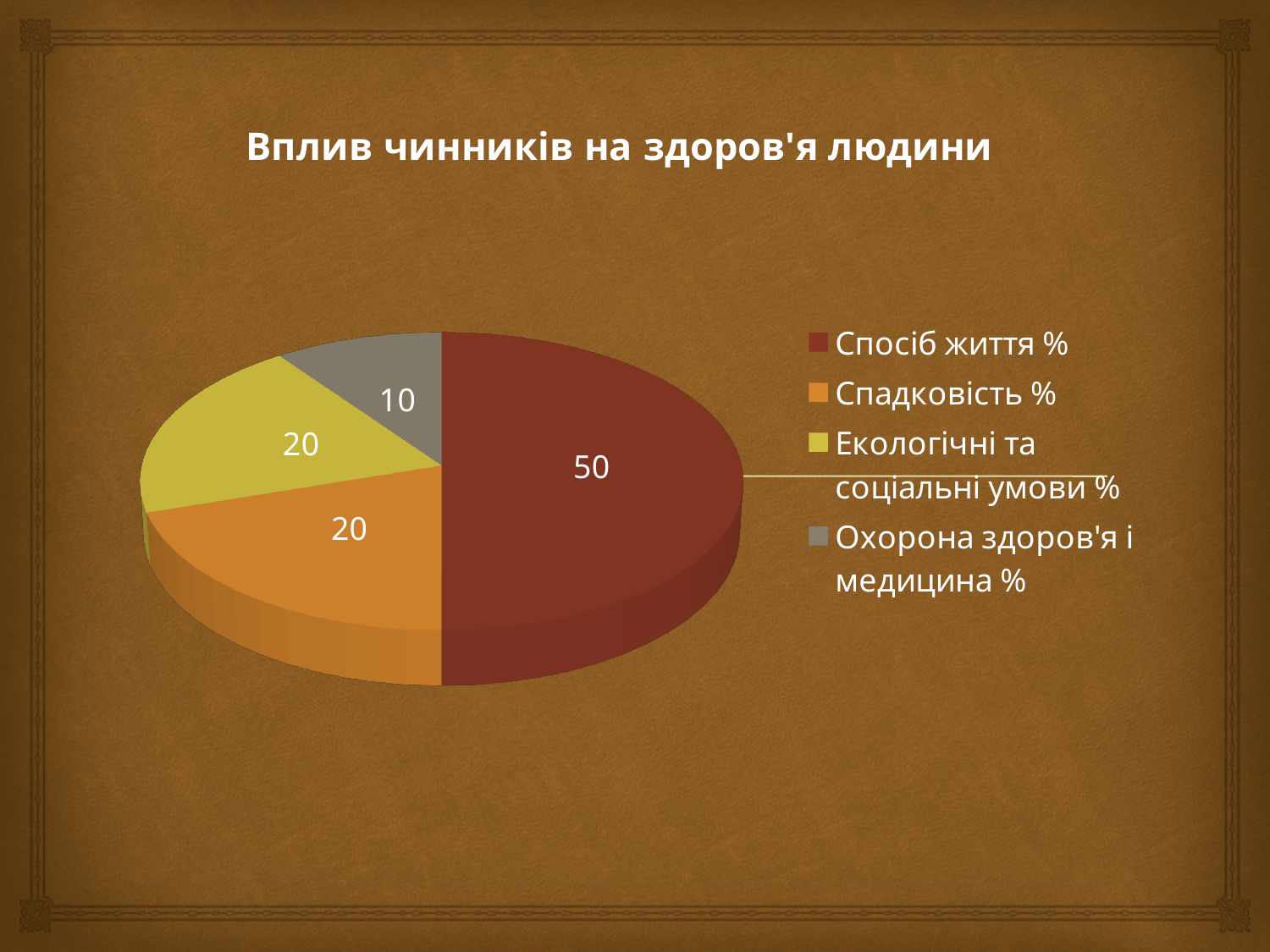
What share of the pie does Спосіб життя % represent? 50% What is the value for Екологічні та соціальні умови %? 20 What kind of chart is shown on the slide? pie chart What is the value for Спадковість %? 20 What is the title of the chart? Вплив чинників на здоров'я людини Which category has the largest slice? Спосіб життя % Which category has the smallest slice? Охорона здоров'я і медицина % What is the value for Охорона здоров'я і медицина %? 10 What is the difference between the values for Спосіб життя % and Спадковість %? 30 How many categories does the legend list? 4 What is the value for Спосіб життя %? 50 Which is larger, the value for Спадковість % or the value for Охорона здоров'я і медицина %? Спадковість %